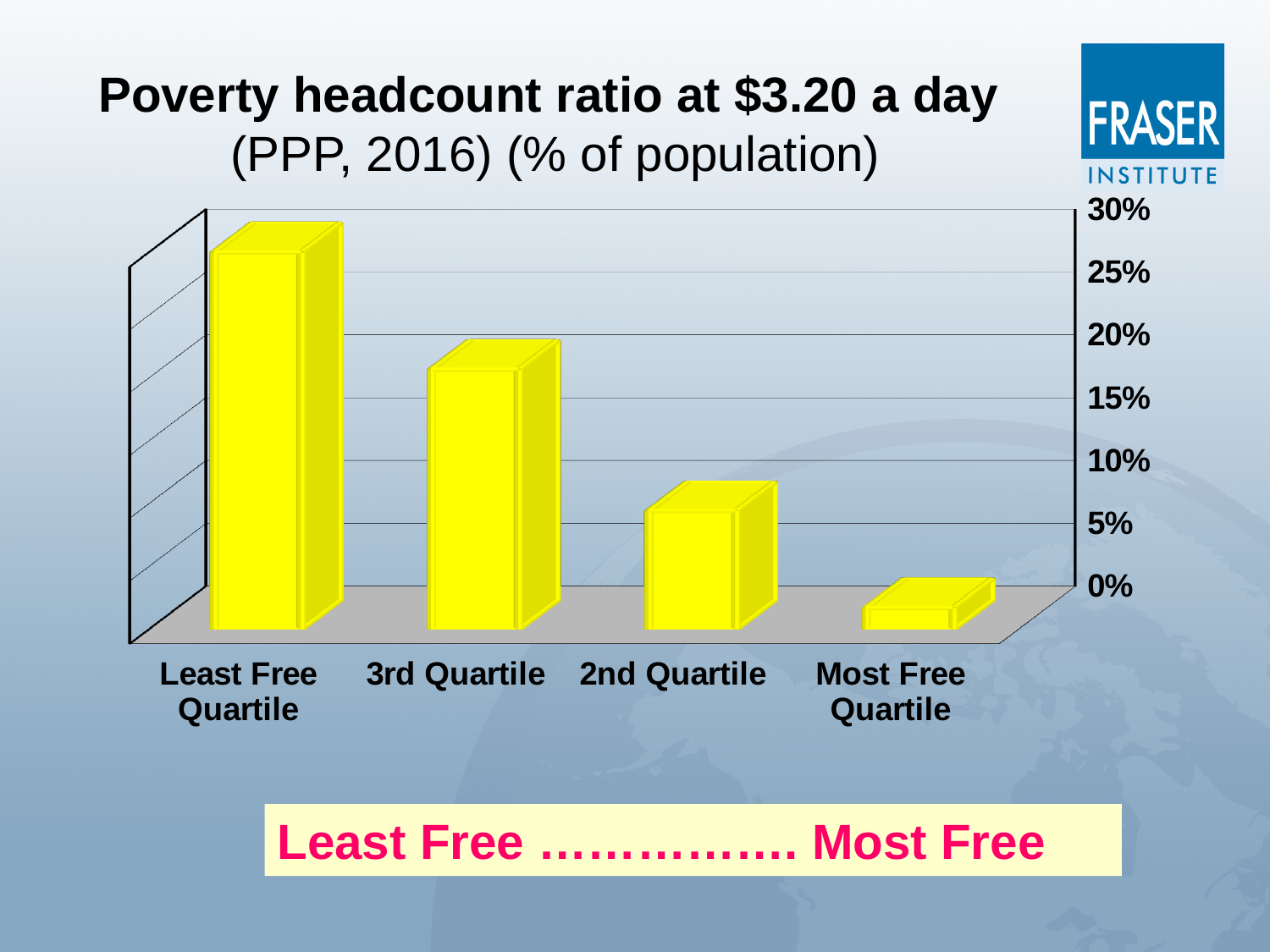
Which category has the highest poverty headcount ratio? Least Free Quartile How many categories are shown on the x axis of the chart? 4 What kind of chart is shown on the slide? bar chart Is the value for the Most Free Quartile greater or less than 5%? less Which is larger, the value for the 3rd Quartile or the value for the 2nd Quartile? 3rd Quartile What is the title of the chart? Poverty headcount ratio at $3.20 a day (PPP, 2016) (% of population) Is the value for the Least Free Quartile greater or less than 25%? greater Which category has the lowest poverty headcount ratio? Most Free Quartile Do the values rise or fall moving from the Least Free Quartile to the Most Free Quartile along the x axis? fall Is the value for the 3rd Quartile greater or less than 15%? greater